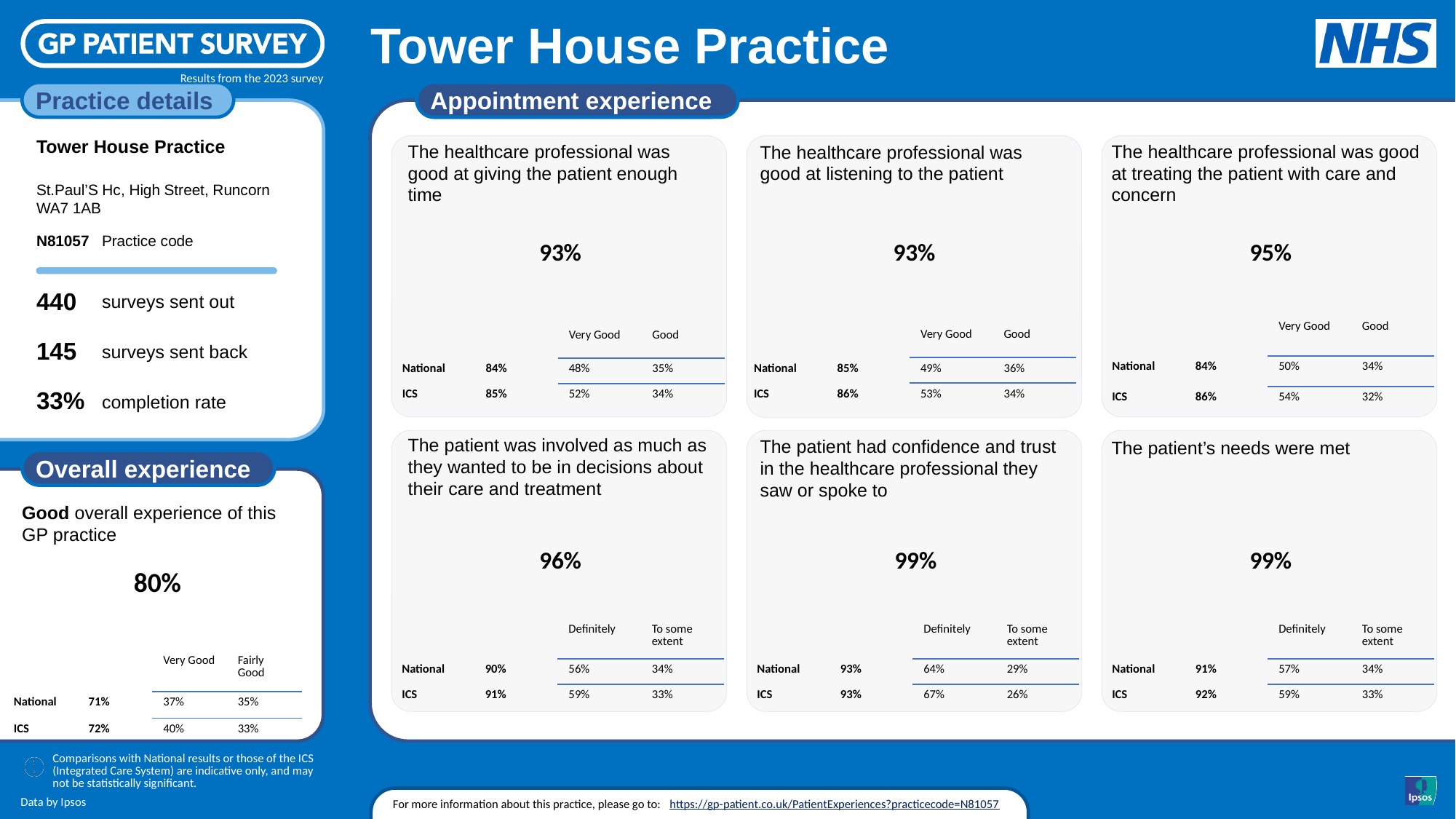
In the panel 'The healthcare professional was good at listening to the patient', what is the difference between the practice's 93% and the National figure of 85%? 8 percentage points In the panel 'The patient's needs were met', what is the ICS overall percentage? 92% In the 'Overall experience' panel, what percentage of patients reported a good overall experience of this GP practice? 80% Among the six Appointment experience panels, which question has the lowest practice headline percentage? The healthcare professional was good at giving the patient enough time (and good at listening to the patient), both 93% In the 'Overall experience' panel, what is the ICS 'Very Good' percentage? 40% In the panel 'The patient was involved as much as they wanted to be in decisions about their care and treatment', what is the National 'Definitely' percentage? 56% How many question panels are shown under the 'Appointment experience' heading? 6 In the 'Overall experience' panel, what is the difference between the practice's 80% and the National figure of 71%? 9 percentage points In the 'Overall experience' panel, what is the National figure for good overall experience? 71% In the panel 'The healthcare professional was good at giving the patient enough time', what is the practice's headline percentage? 93% In the panel 'The healthcare professional was good at treating the patient with care and concern', what is the ICS 'Very Good' percentage? 54% In the panel 'The patient had confidence and trust in the healthcare professional they saw or spoke to', which is larger: the National 'Definitely' percentage or the ICS 'Definitely' percentage? ICS (67%)